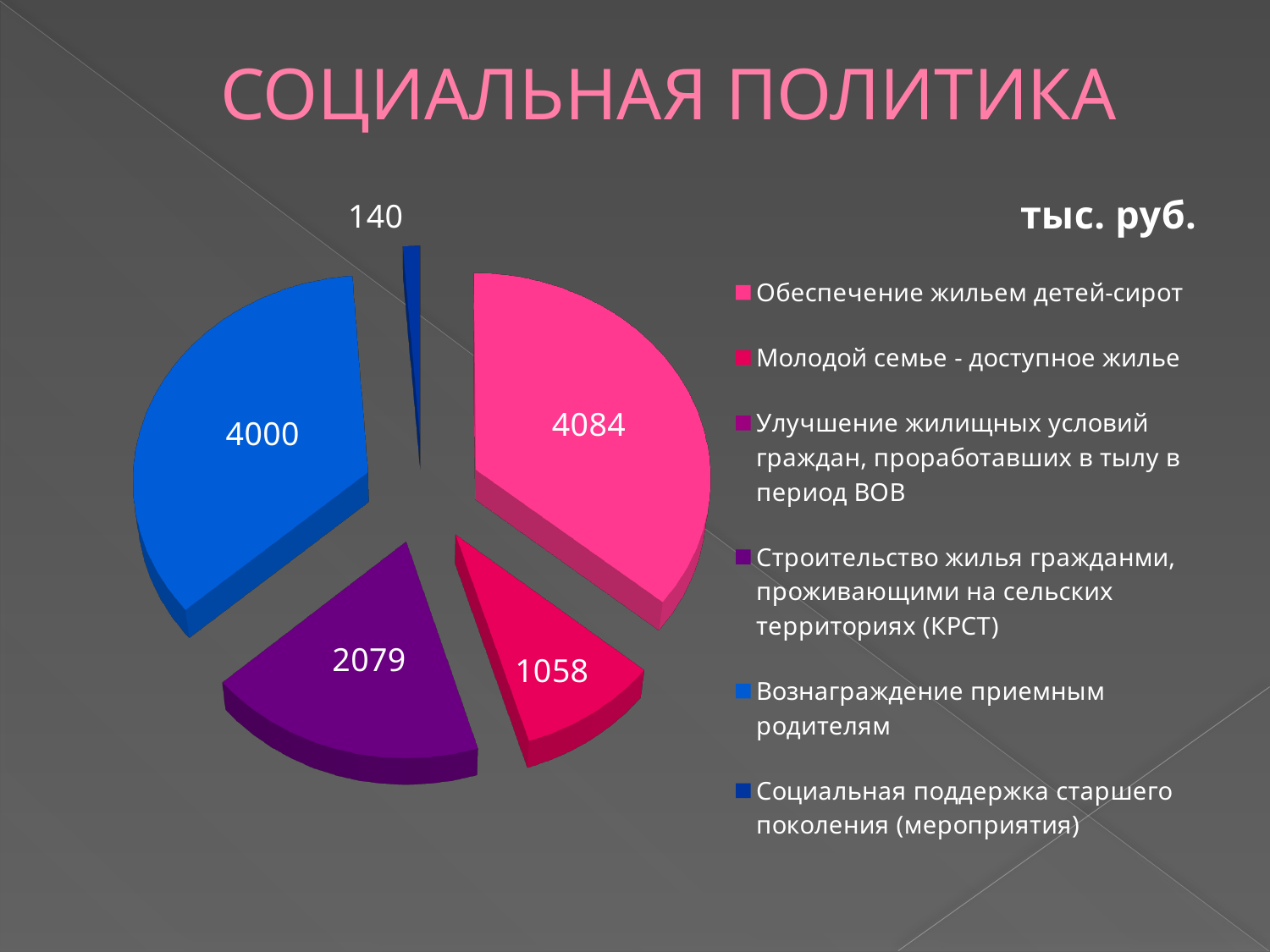
What type of chart is shown on the slide? pie chart In what unit are the chart values given, according to the slide? тыс. руб. What is the difference between the values for Вознаграждение приемным родителям and Молодой семье - доступное жилье? 2942 What is the value for Вознаграждение приемным родителям? 4000 What is the difference between the values for Обеспечение жильем детей-сирот and Вознаграждение приемным родителям? 84 What is the value for Обеспечение жильем детей-сирот? 4084 Which category has the largest slice of the pie? Обеспечение жильем детей-сирот Which is larger: the value for Молодой семье - доступное жилье or the value for Вознаграждение приемным родителям? Вознаграждение приемным родителям How many data labels are shown on the pie slices? 5 Which category has the smallest slice of the pie? Социальная поддержка старшего поколения (мероприятия) What is the value for Социальная поддержка старшего поколения (мероприятия)? 140 What is the value for Молодой семье - доступное жилье? 1058